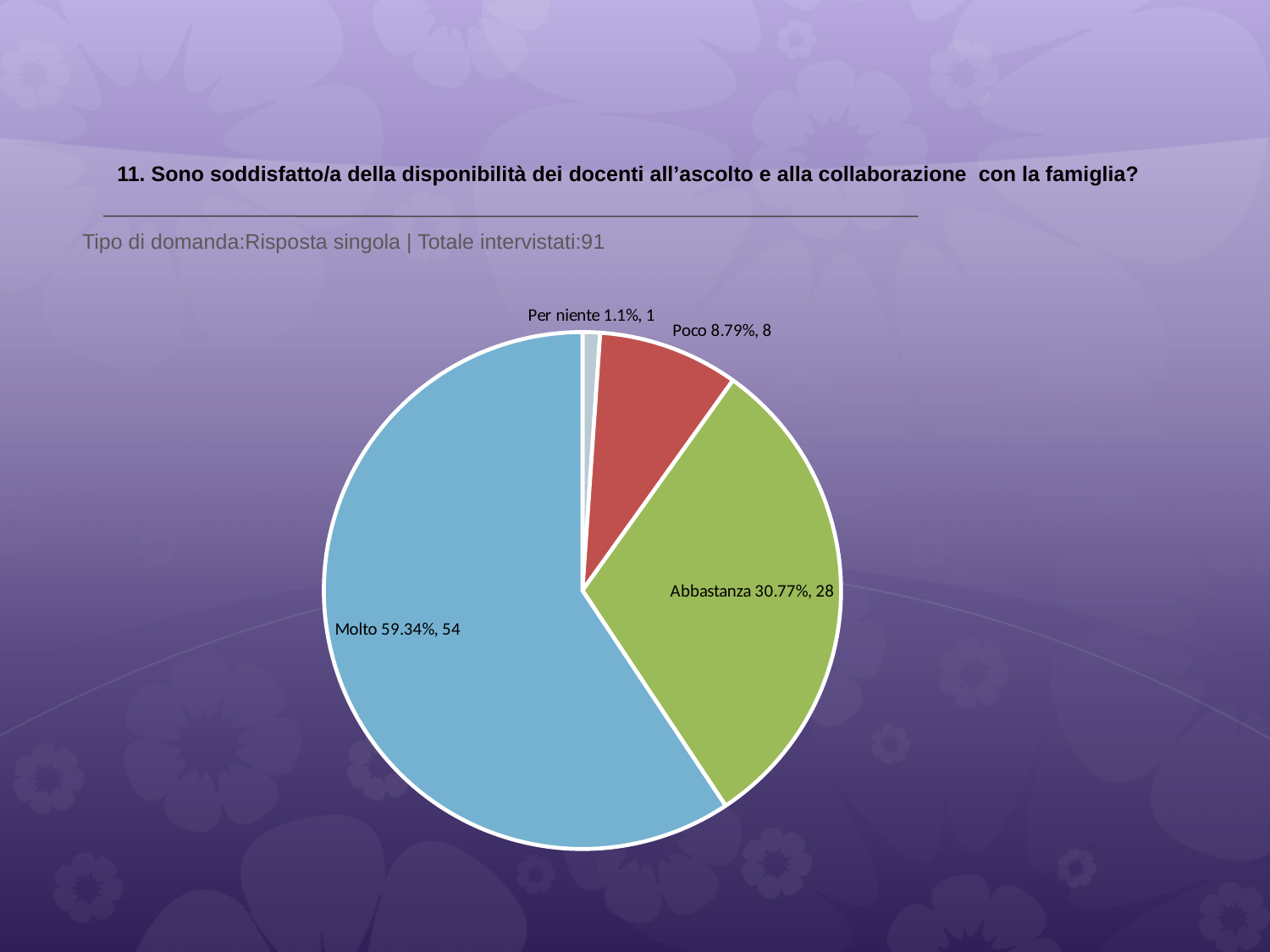
How many respondents answered 'Per niente'? 1 What is the total number of respondents across all slices? 91 What is the difference in number of respondents between 'Molto' and 'Abbastanza'? 26 Which has more respondents, 'Poco' or 'Abbastanza'? Abbastanza How many slices does the pie chart have? 4 What percentage share does the 'Poco' slice have? 8.79% How many respondents answered 'Abbastanza'? 28 Which response category has the largest slice? Molto What percentage share does the 'Molto' slice have? 59.34% Which response category has the smallest slice? Per niente What colour is the 'Abbastanza' slice? green What kind of chart is shown on the slide? pie chart